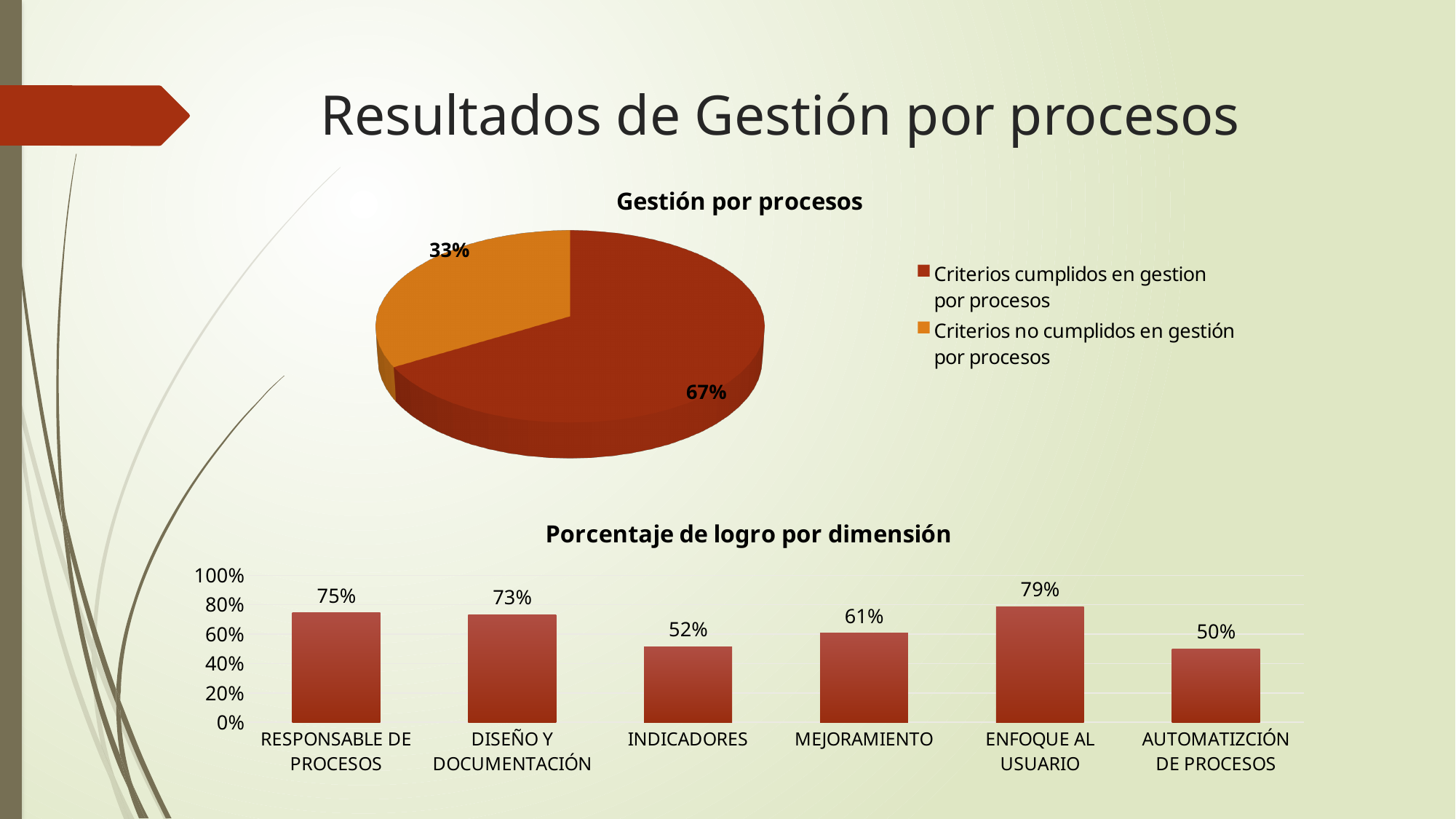
In the 'Porcentaje de logro por dimensión' chart, what is the difference between RESPONSABLE DE PROCESOS and DISEÑO Y DOCUMENTACIÓN? 2% In the 'Porcentaje de logro por dimensión' chart, which category has the lowest value? AUTOMATIZCIÓN DE PROCESOS In the 'Porcentaje de logro por dimensión' chart, which is larger: MEJORAMIENTO or INDICADORES? MEJORAMIENTO In the 'Gestión por procesos' chart, what share of the pie is 'Criterios no cumplidos en gestión por procesos'? 33% In the 'Porcentaje de logro por dimensión' chart, what is the value for MEJORAMIENTO? 61% What kind of chart is 'Porcentaje de logro por dimensión'? Bar chart In the 'Gestión por procesos' chart, what share of the pie is 'Criterios cumplidos en gestion por procesos'? 67% What kind of chart is 'Gestión por procesos'? Pie chart How many categories are shown in the 'Porcentaje de logro por dimensión' chart? 6 In the 'Porcentaje de logro por dimensión' chart, which category has the highest value? ENFOQUE AL USUARIO How many entries does the legend of the 'Gestión por procesos' chart list? 2 In the 'Porcentaje de logro por dimensión' chart, what is the value for INDICADORES? 52%